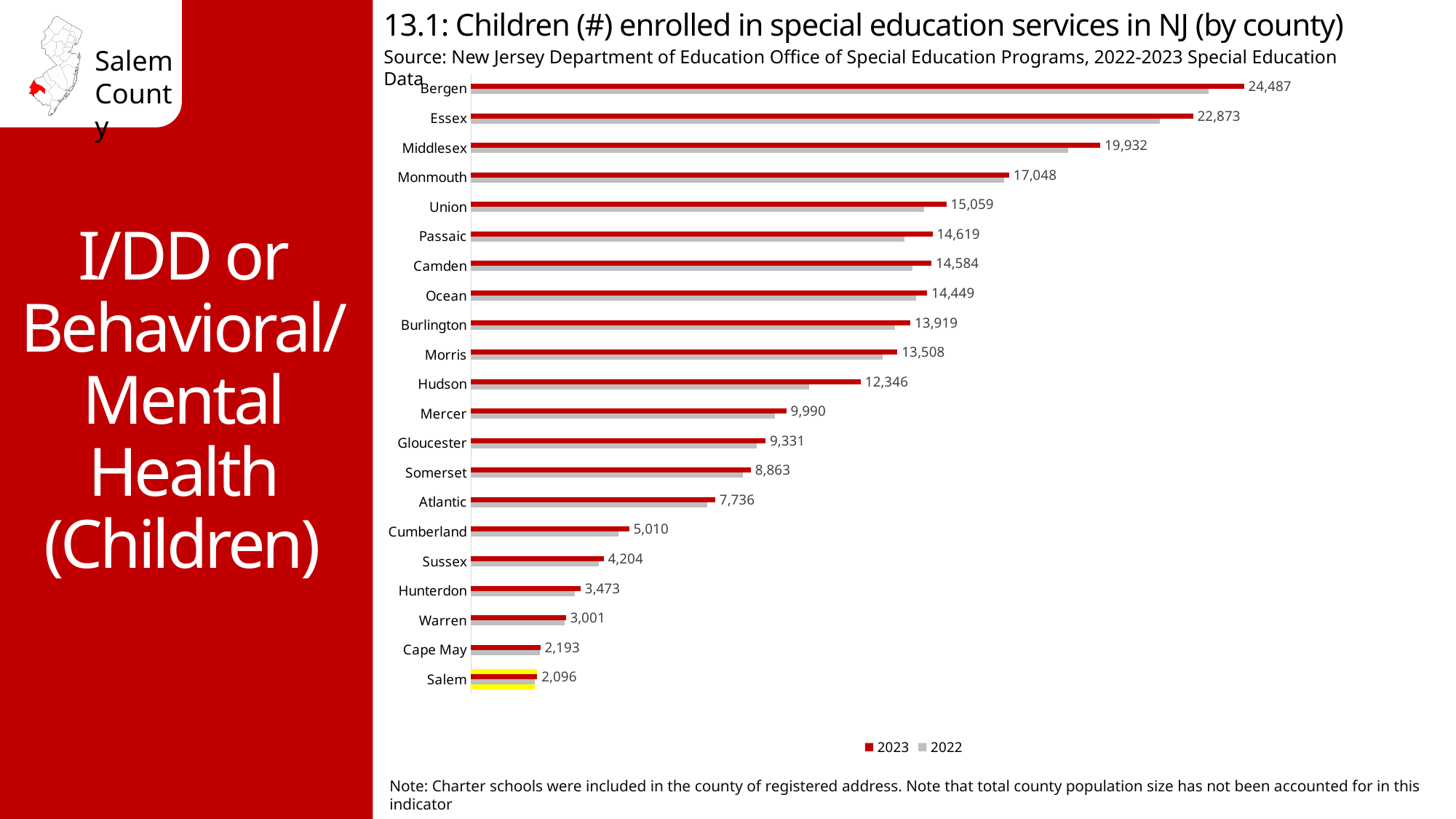
What is the difference between the 2023 values for Bergen and Salem counties? 22,391 Which county has the highest number of children enrolled in special education services in 2023? Bergen How many counties are shown on the chart? 21 What is the difference between the 2023 values for Cape May and Salem counties? 97 What is the 2023 value shown for Gloucester County? 9,331 What is the 2023 value for Salem County? 2,096 How many series does the legend list? 2 For Hudson County, which year's bar is longer, 2023 or 2022? 2023 Which county has the lowest number of children enrolled in special education services in 2023? Salem Which county has a larger 2023 value, Passaic or Camden? Passaic How many children were enrolled in special education services in Bergen County in 2023? 24,487 What type of chart is shown on the slide? Bar chart